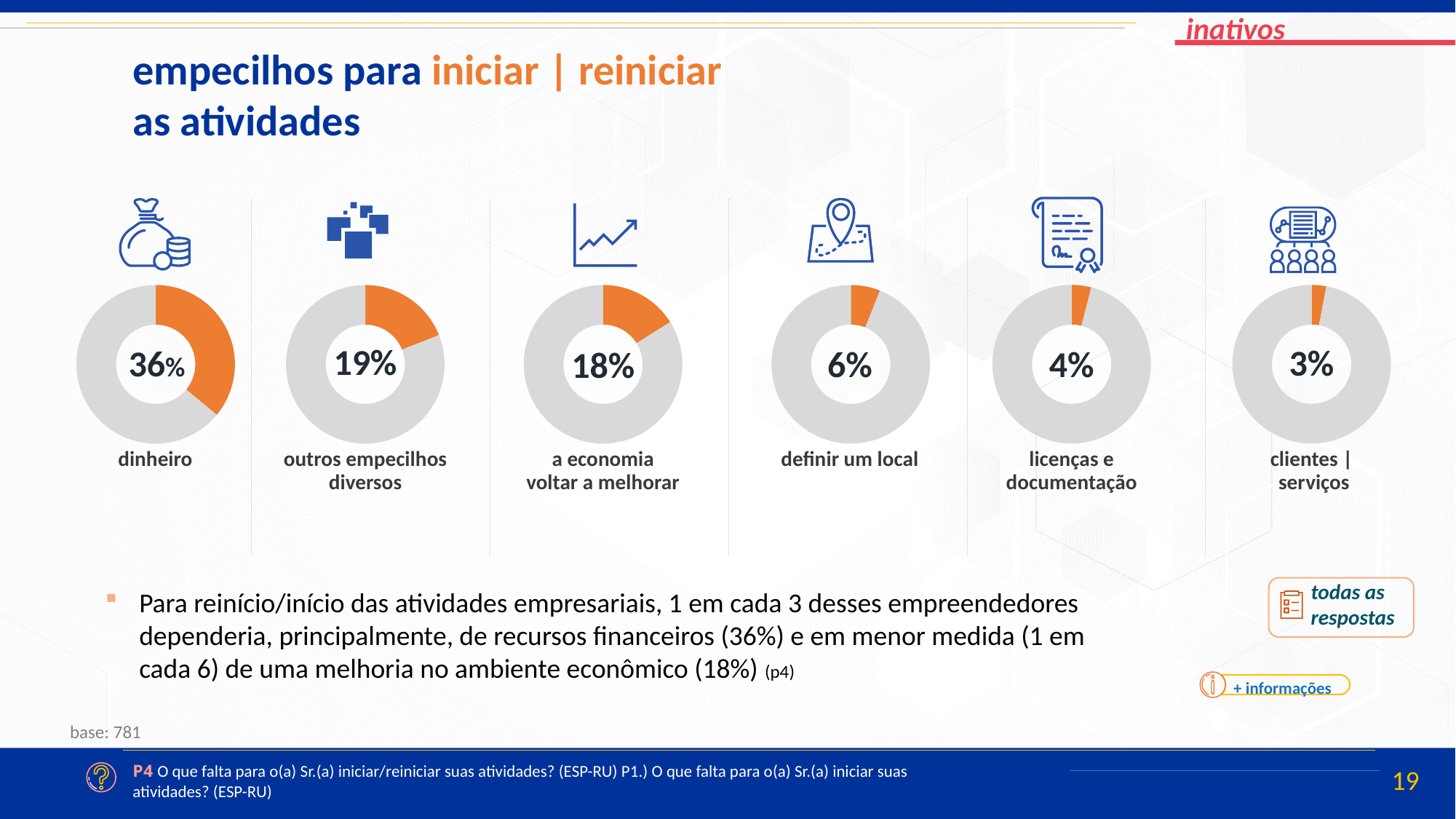
Which is larger: the percentage in the "definir um local" chart or the percentage in the "licenças e documentação" chart? definir um local In the donut chart labelled "definir um local", what percentage is shown? 6% In the donut chart labelled "a economia voltar a melhorar", what percentage is shown? 18% Across the six donut charts on the slide, which category has the highest percentage? dinheiro In the donut chart labelled "outros empecilhos diversos", what percentage is shown? 19% What kind of chart is used to show each percentage on the slide? Donut (pie) chart In the donut chart labelled "clientes | serviços", what percentage is shown? 3% What is the difference between the percentage in the "dinheiro" chart and the percentage in the "a economia voltar a melhorar" chart? 18% How many donut charts are shown on the slide? 6 In the donut chart labelled "licenças e documentação", what percentage is shown? 4% Across the six donut charts on the slide, which category has the lowest percentage? clientes | serviços In the donut chart labelled "dinheiro", what percentage is shown? 36%